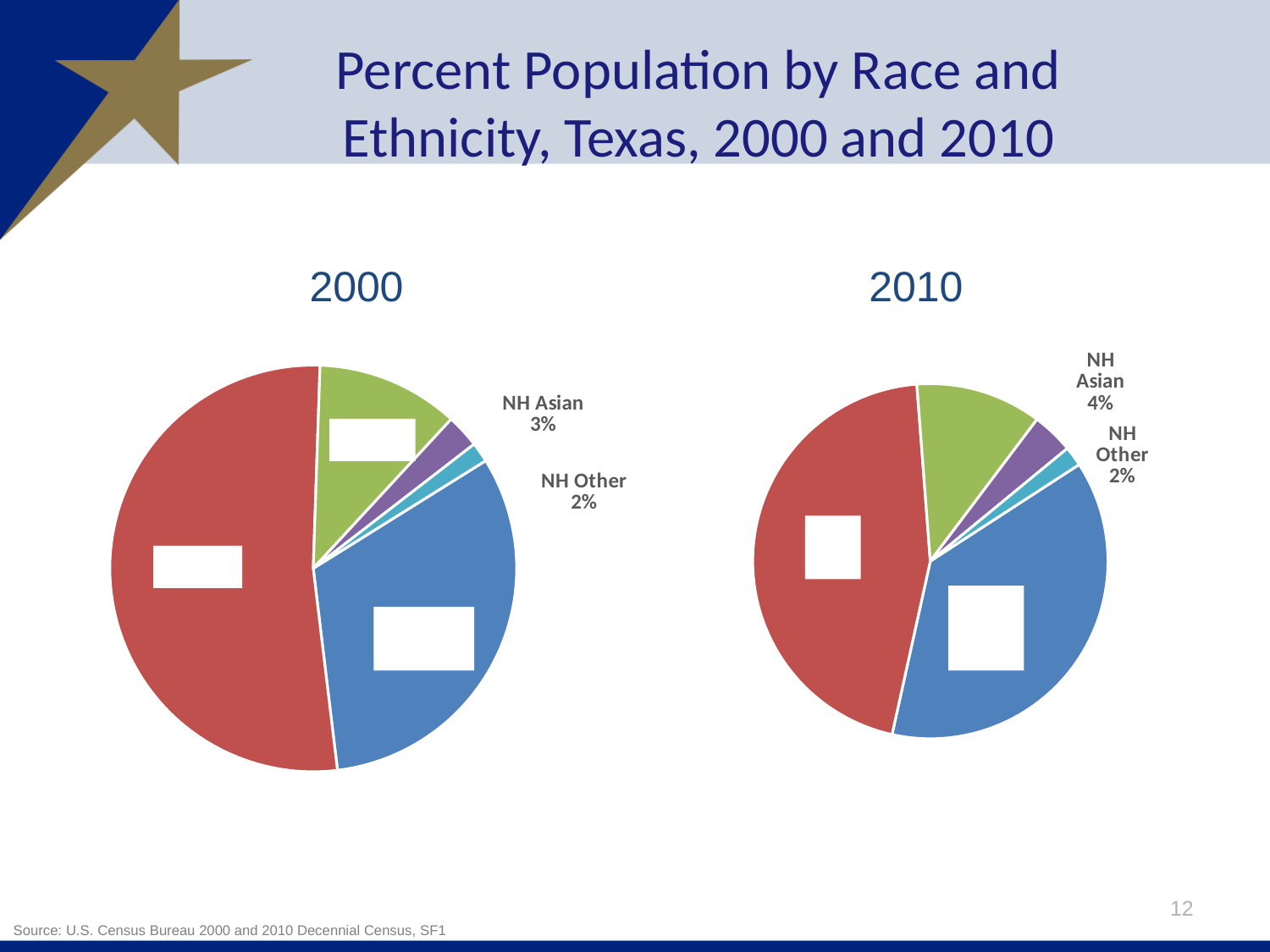
What type of chart is used for the 2000 data? Pie chart In the 2000 pie chart, which is larger, the NH Asian slice or the NH Other slice? NH Asian In the 2010 pie chart, what colour is the largest slice? Red In the 2000 pie chart, what percentage is shown for NH Asian? 3% In the 2000 pie chart, what percentage is shown for NH Other? 2% Comparing the 2000 and 2010 pie charts, in which year is the NH Asian share larger? 2010 How many slices does the 2010 pie chart have? 5 In the 2010 pie chart, what percentage is shown for NH Other? 2% In the 2010 pie chart, what percentage is shown for NH Asian? 4% How many pie charts are shown on the slide? 2 In the 2010 pie chart, what is the difference between the NH Asian share and the NH Other share? 2 percentage points By how many percentage points did the NH Asian share change from the 2000 pie chart to the 2010 pie chart? 1 percentage point